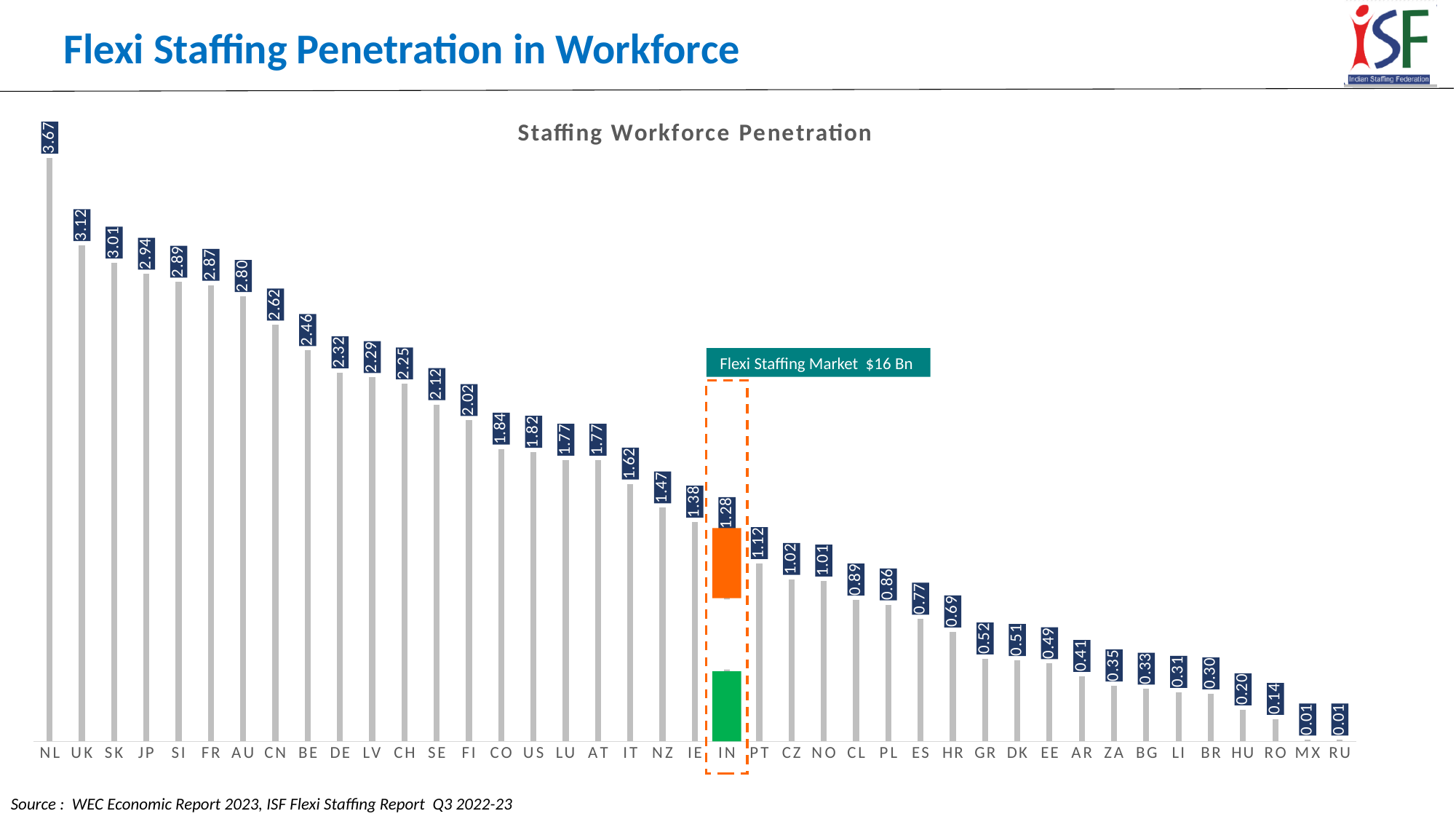
What is the difference between the values for NL and UK? 0.55 What kind of chart is shown on the slide? Bar chart What is the value for IN? 1.28 What is the lowest value shown on the chart? 0.01 What is the difference between the values for IN and PT? 0.16 Do the values rise or fall from left to right along the x axis? Fall Which is larger, the value for DE or the value for CH? DE Which country has the highest staffing workforce penetration? NL What is the value for NL? 3.67 What is the value for US? 1.82 What is the title of the chart? Staffing Workforce Penetration How many countries are shown on the chart? 41